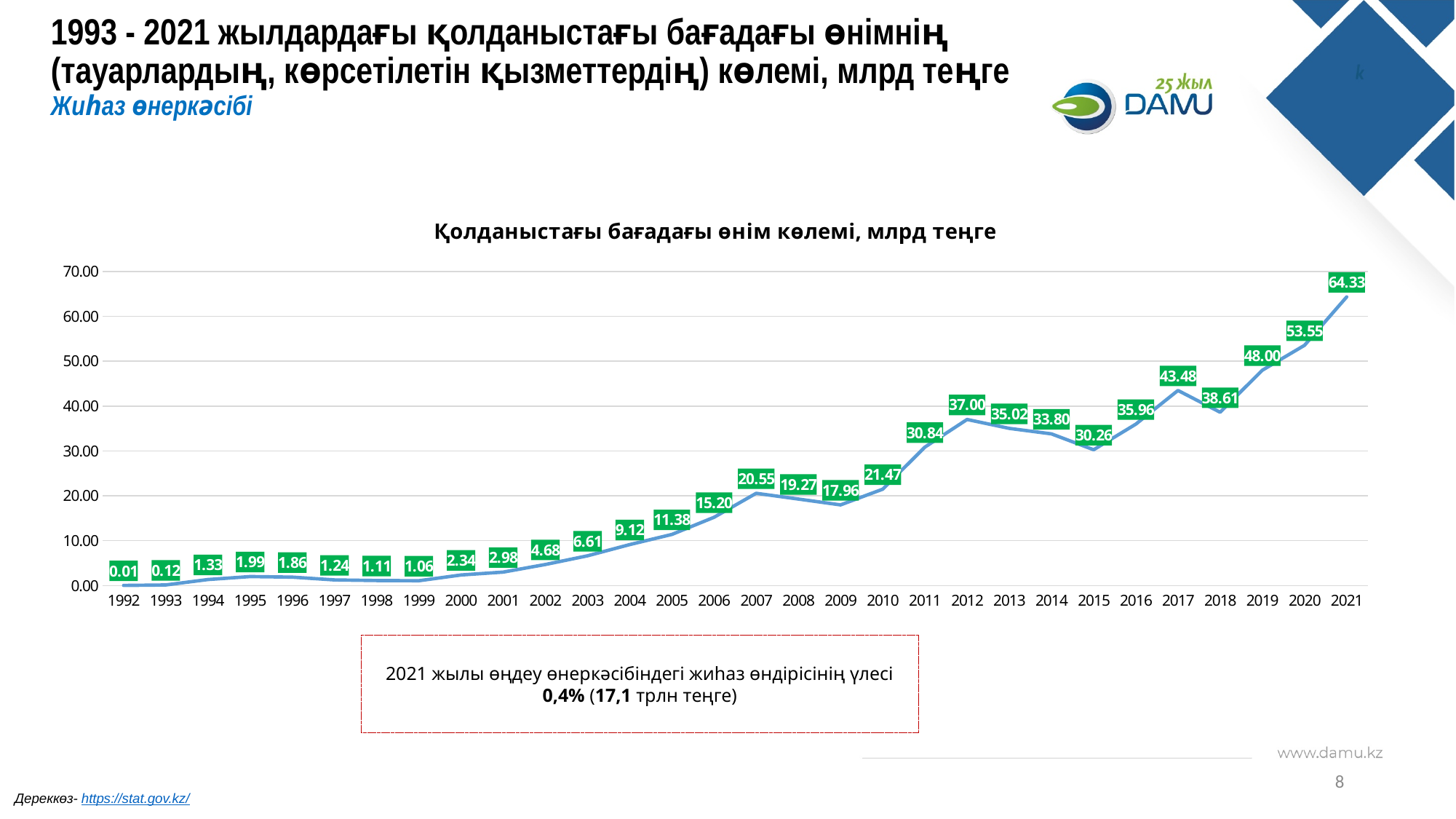
How many years are plotted on the chart? 30 What is the value for 2021? 64.33 What is the value for 2007? 20.55 Is the value for 2019 greater or less than 40.00? greater Do the values generally rise or fall from 1992 to 2021? rise What is the title of the chart? Қолданыстағы бағадағы өнім көлемі, млрд теңге Which year has the highest value? 2021 Which is larger, the value for 2017 or the value for 2018? 2017 What kind of chart is shown on the slide? line chart What is the difference between the values for 2021 and 2020? 10.78 What is the value for 2012? 37.00 Which year has the lowest value? 1992